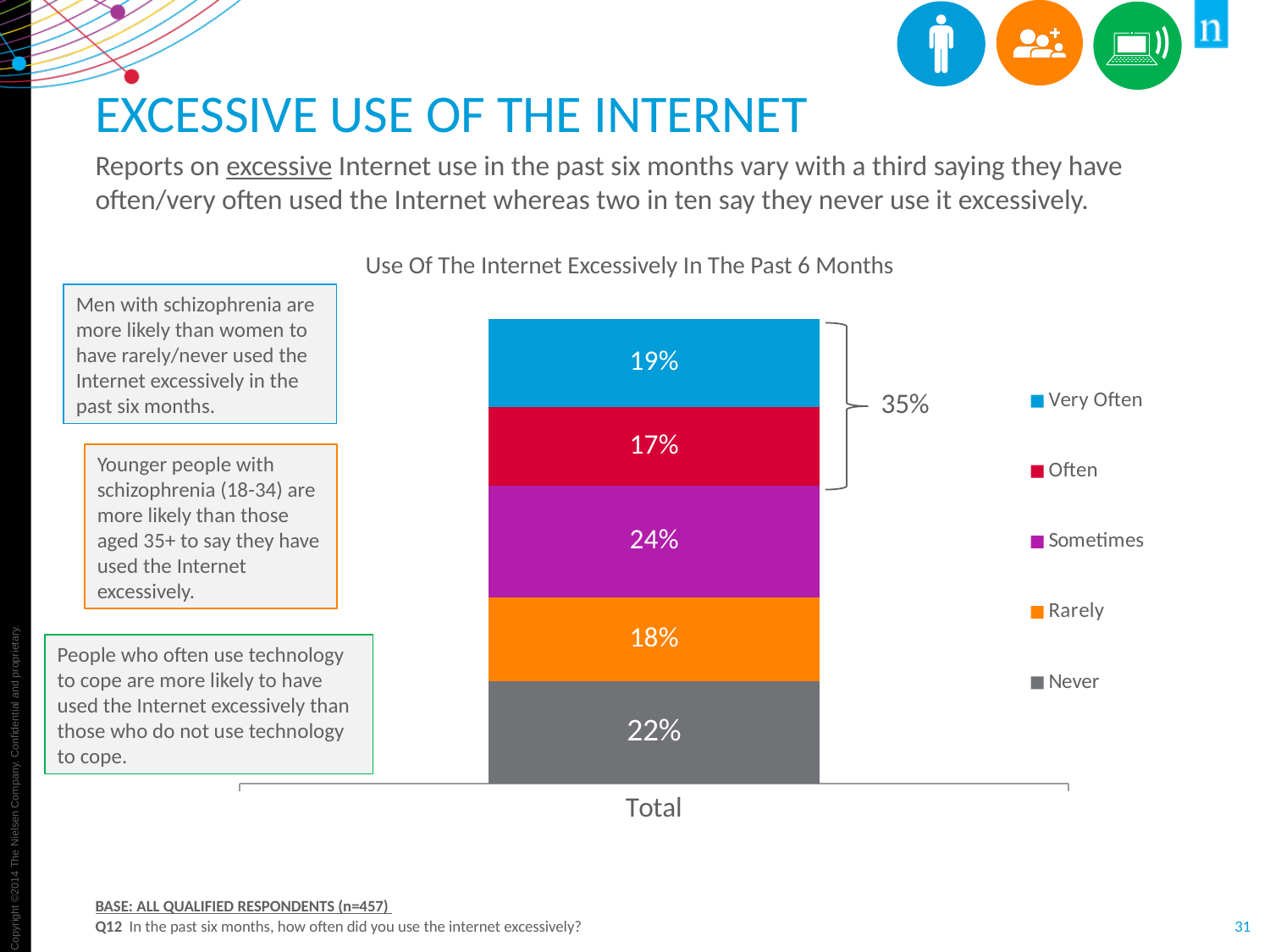
How many series does the legend list? 5 What is the combined percentage for 'Very Often' and 'Often' shown by the bracket? 35% What percentage of respondents said 'Rarely'? 18% Which is larger, the 'Never' percentage or the 'Very Often' percentage? Never What percentage of respondents said they used the Internet excessively 'Very Often'? 19% What kind of chart is shown on the slide? Stacked bar chart Which response category has the lowest percentage? Often What percentage of respondents said 'Sometimes'? 24% What is the difference between the 'Sometimes' and 'Often' percentages? 7% What is the title of the chart? Use Of The Internet Excessively In The Past 6 Months Which response category has the highest percentage? Sometimes What percentage of respondents said 'Never'? 22%